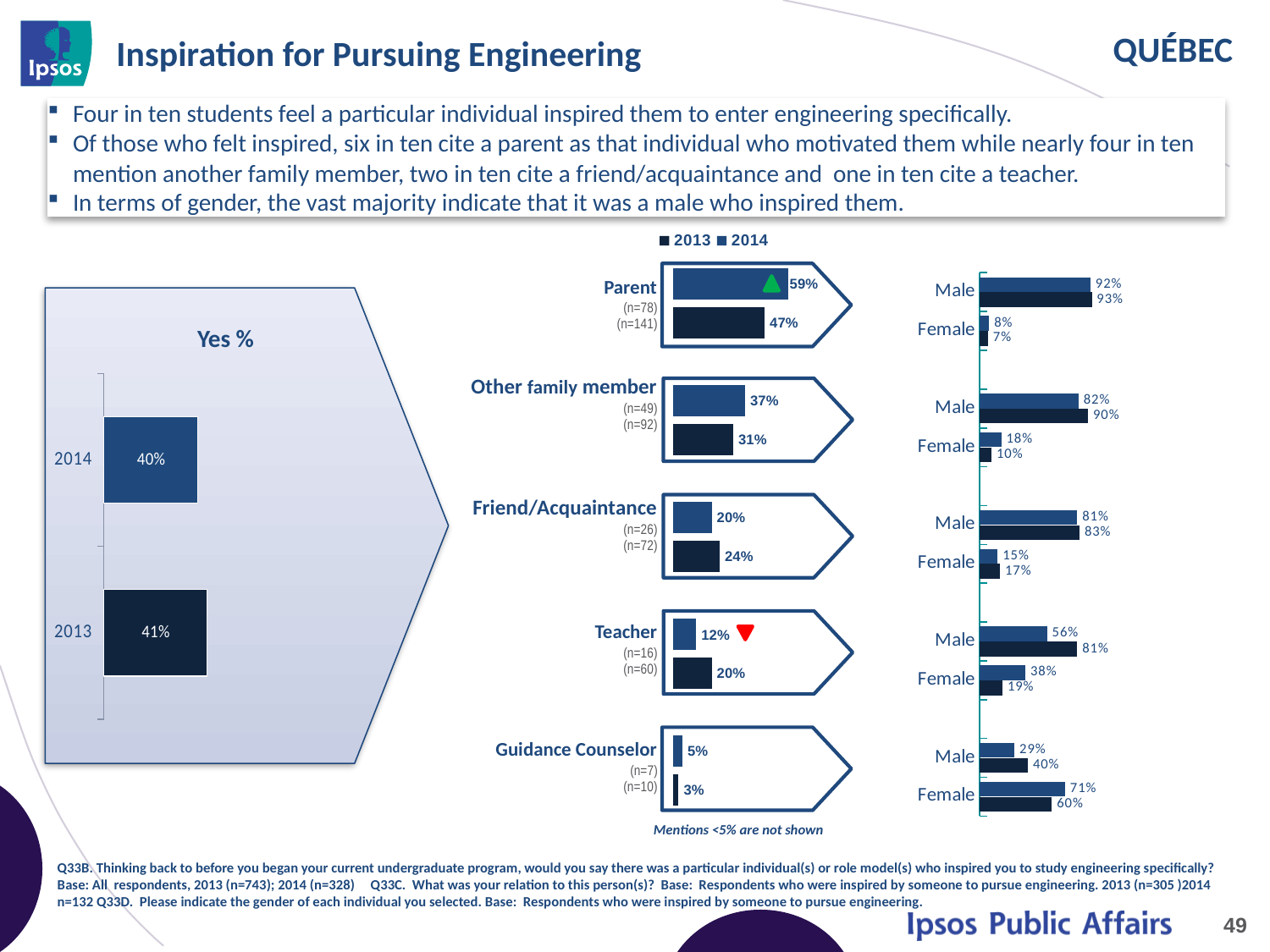
How many series does the legend above the middle chart list? 2 In the middle chart of relations, which category has the highest value? Parent In the middle chart of relations to the inspiring person, how many relation categories are shown? 5 In the gender chart on the right, for Guidance Counselor, which is larger: the upper Male bar or the upper Female bar? Female In the gender chart on the right, what is the value of the upper Male bar in the Parent group? 92% What note is printed below the middle chart of relations? Mentions <5% are not shown What kind of chart is the 'Yes %' chart on the left? Bar chart In the middle chart of relations, what is the difference between the two bars for Parent (59% and 47%)? 12 percentage points In the 'Yes %' chart on the left, what is the value for 2014? 40% In the middle chart of relations, which category has the lowest values? Guidance Counselor In the middle chart of relations, what is the value of the upper bar for Teacher? 12% In the 'Yes %' chart on the left, what is the value for 2013? 41%